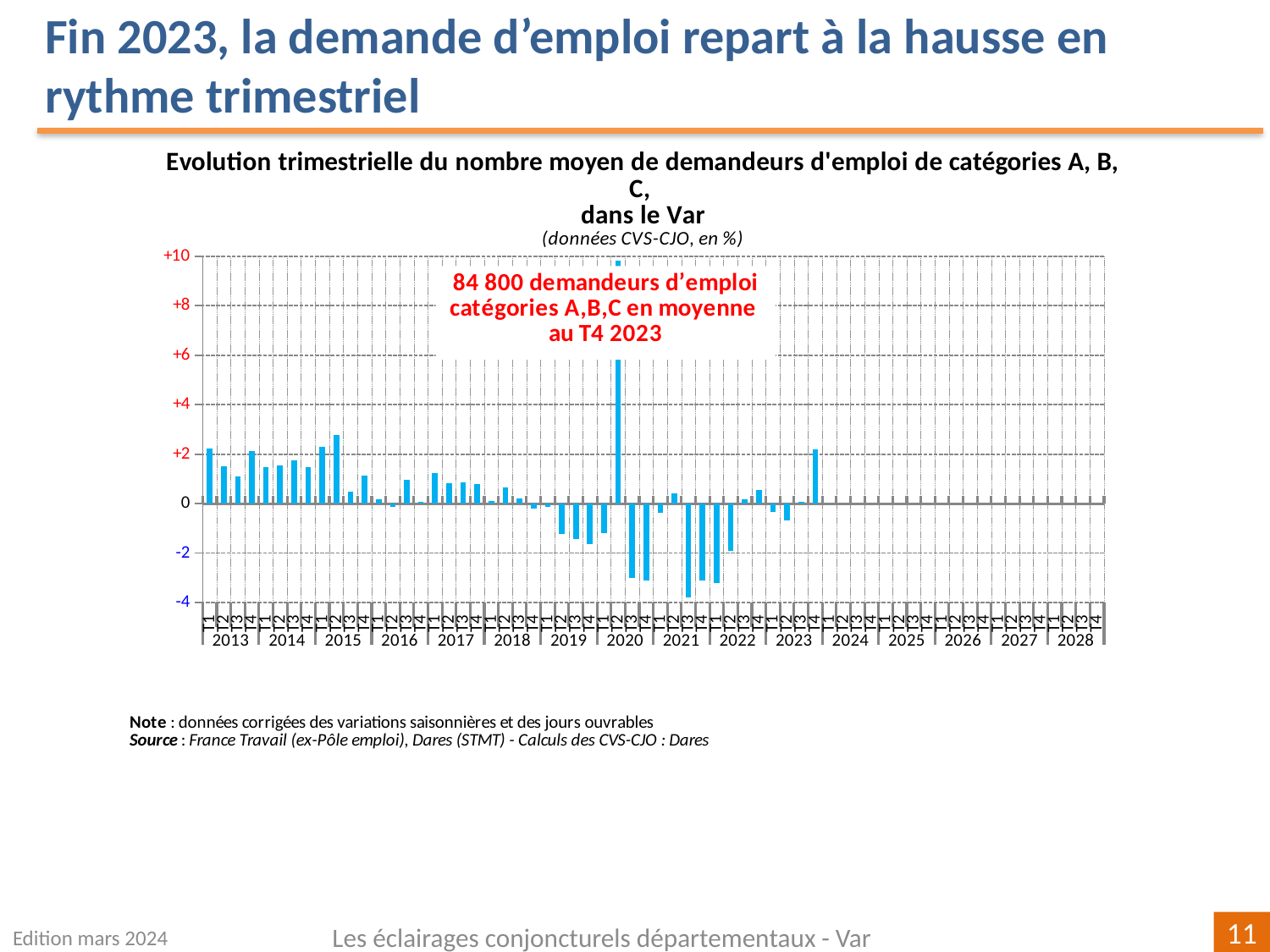
Which is larger, the value for T2 2020 or the value for T4 2023? T2 2020 How many years are labelled on the x axis of the chart? 16 Which is larger, the value for T1 2019 or the value for T3 2020? T1 2019 What is the last year for which bars are plotted on the chart? 2023 Which quarter has the highest value on the chart? T2 2020 What kind of chart is shown on the slide? Bar chart According to the annotation on the chart, how many demandeurs d'emploi catégories A,B,C were there on average in T4 2023? 84 800 Is the value for T2 2015 greater or less than +2? greater Is the value for T3 2020 greater or less than -2? less Is the value for T2 2020 greater or less than +4? greater Which quarter has the lowest value on the chart? T3 2021